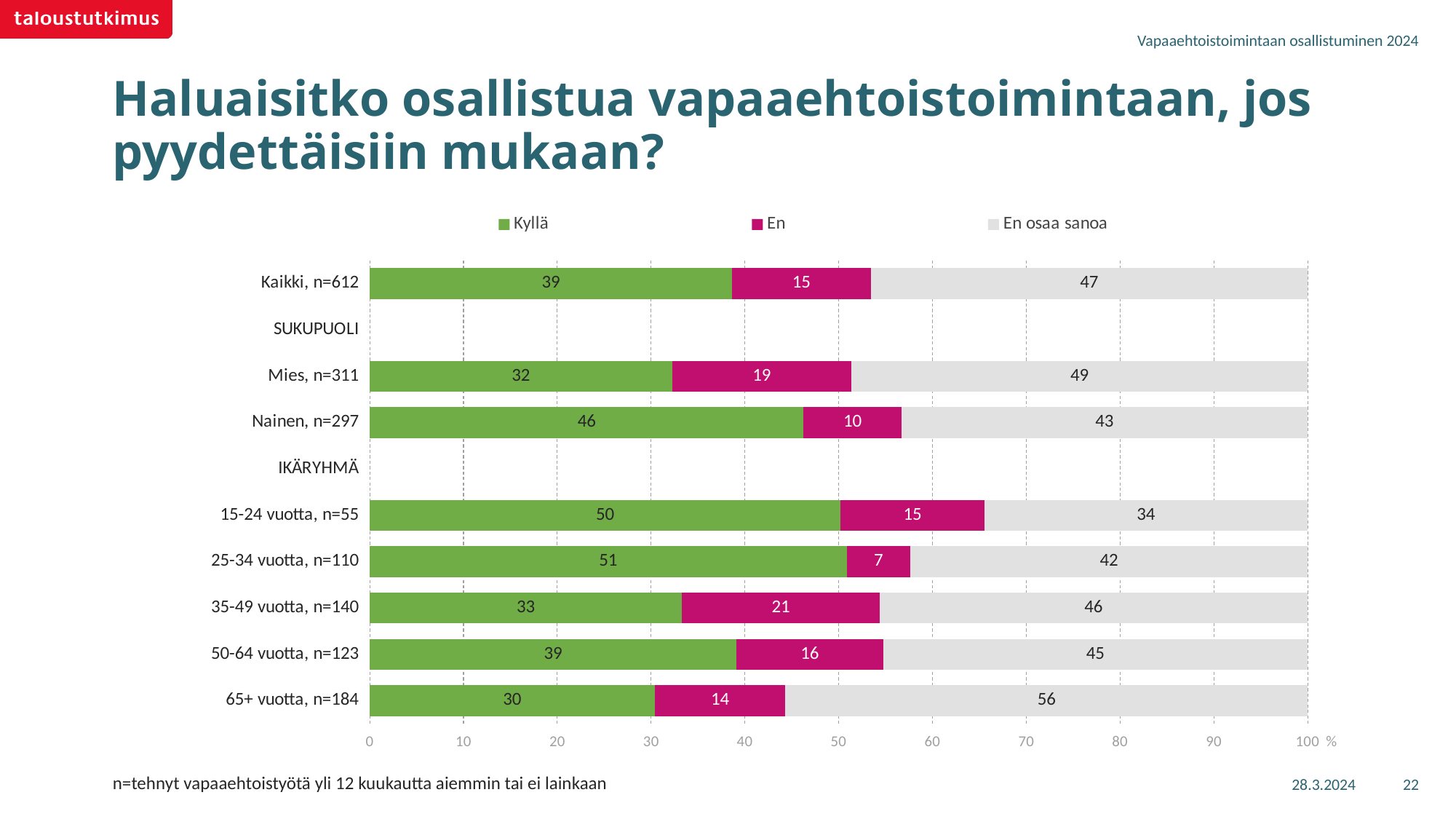
What kind of chart is shown on the slide? Stacked bar chart Which has a larger "En" value, "35-49 vuotta, n=140" or "50-64 vuotta, n=123"? 35-49 vuotta, n=140 How many series does the legend list? 3 What is the difference between the "Kyllä" values for "Nainen, n=297" and "Mies, n=311"? 14 Which category has the lowest "En" value? 25-34 vuotta, n=110 What is the total of the stacked bar for "15-24 vuotta, n=55"? 99 What is the "Kyllä" value for "65+ vuotta, n=184"? 30 Which series is shown in green? Kyllä What is the "En osaa sanoa" value for "65+ vuotta, n=184"? 56 Which category has the highest "Kyllä" value? 25-34 vuotta, n=110 What is the "En" value for "Mies, n=311"? 19 What is the "Kyllä" value for "Kaikki, n=612"? 39